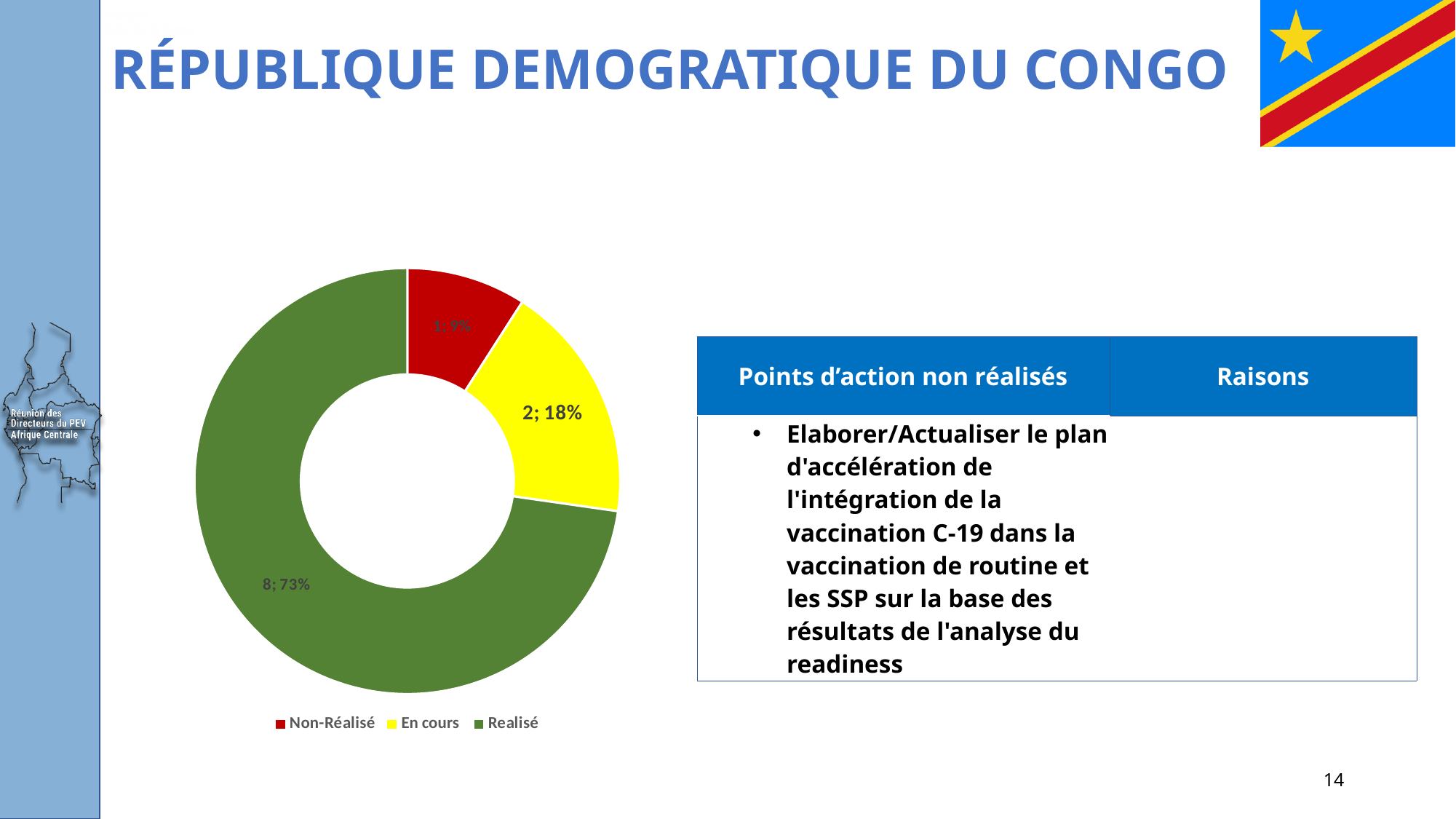
Which category has the smallest slice in the doughnut chart? Non-Réalisé Which category has the largest slice in the doughnut chart? Realisé How many categories does the legend of the doughnut chart list? 3 What percentage share does the Non-Réalisé slice have in the doughnut chart? 9% What is the count value shown for the Non-Réalisé slice? 1 What is the count value shown for the Realisé slice? 8 What kind of chart is shown on the slide? Doughnut chart What percentage share does the En cours slice have in the doughnut chart? 18% What is the count value shown for the En cours slice? 2 What percentage share does the Realisé slice have in the doughnut chart? 73% What is the difference in count between the Realisé and En cours slices? 6 Which colour represents the En cours category in the doughnut chart? Yellow